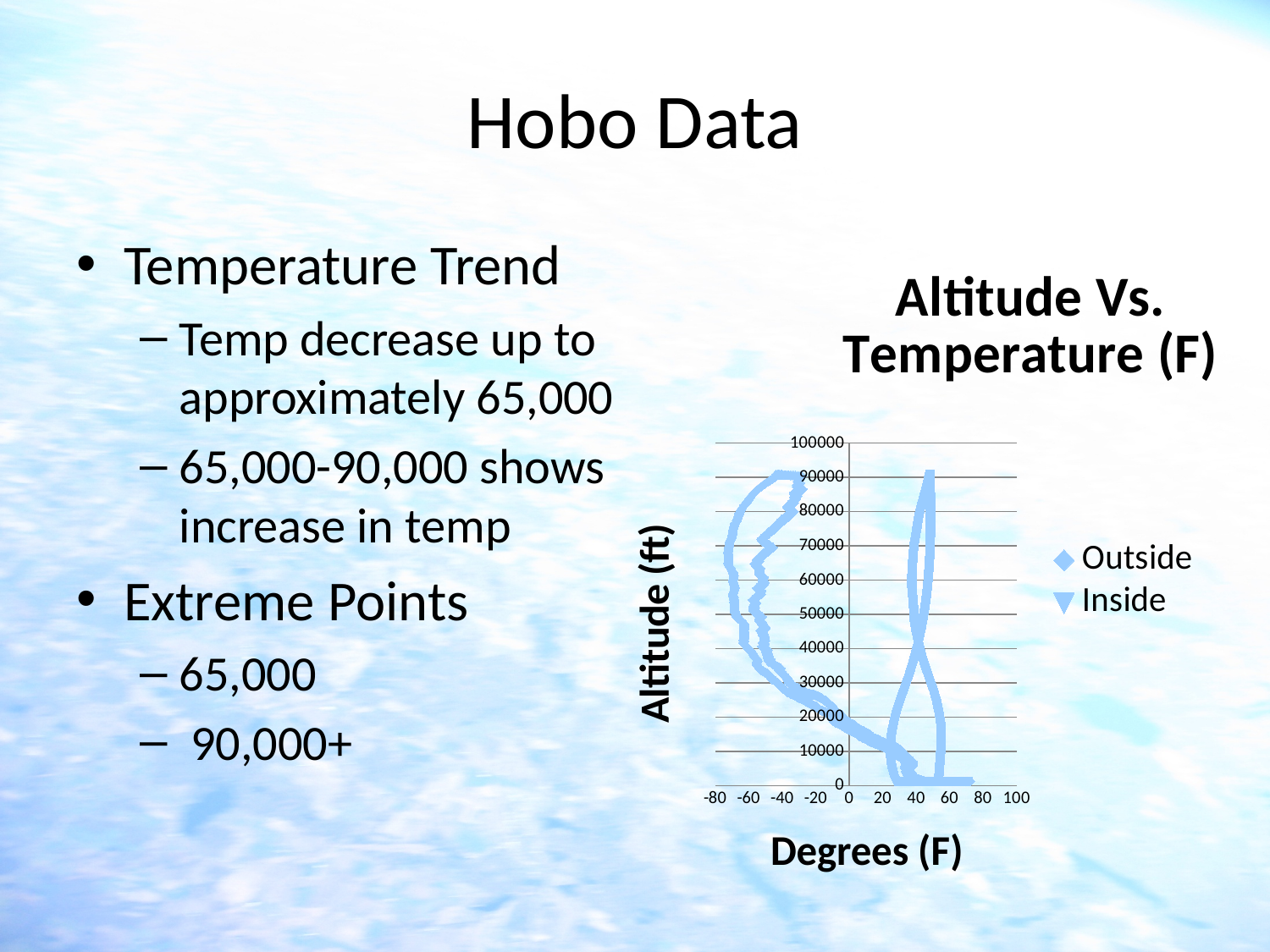
How many series does the chart legend list? 2 What is the highest tick value shown on the vertical (Altitude) axis? 100000 Is the Inside temperature at 60000 ft greater or less than 0? greater At an altitude of 50000 ft, which series shows the higher temperature, Outside or Inside? Inside Does the Outside temperature rise or fall as altitude increases from 0 to 60000 ft? fall What is the label of the vertical axis of the chart? Altitude (ft) What is the title of the chart? Altitude Vs. Temperature (F) What kind of chart is shown on the slide? scatter chart What are the two series named in the chart legend? Outside and Inside Is the Outside temperature at 60000 ft greater or less than -40? less What is the lowest tick value shown on the horizontal (Degrees) axis? -80 What is the label of the horizontal axis of the chart? Degrees (F)